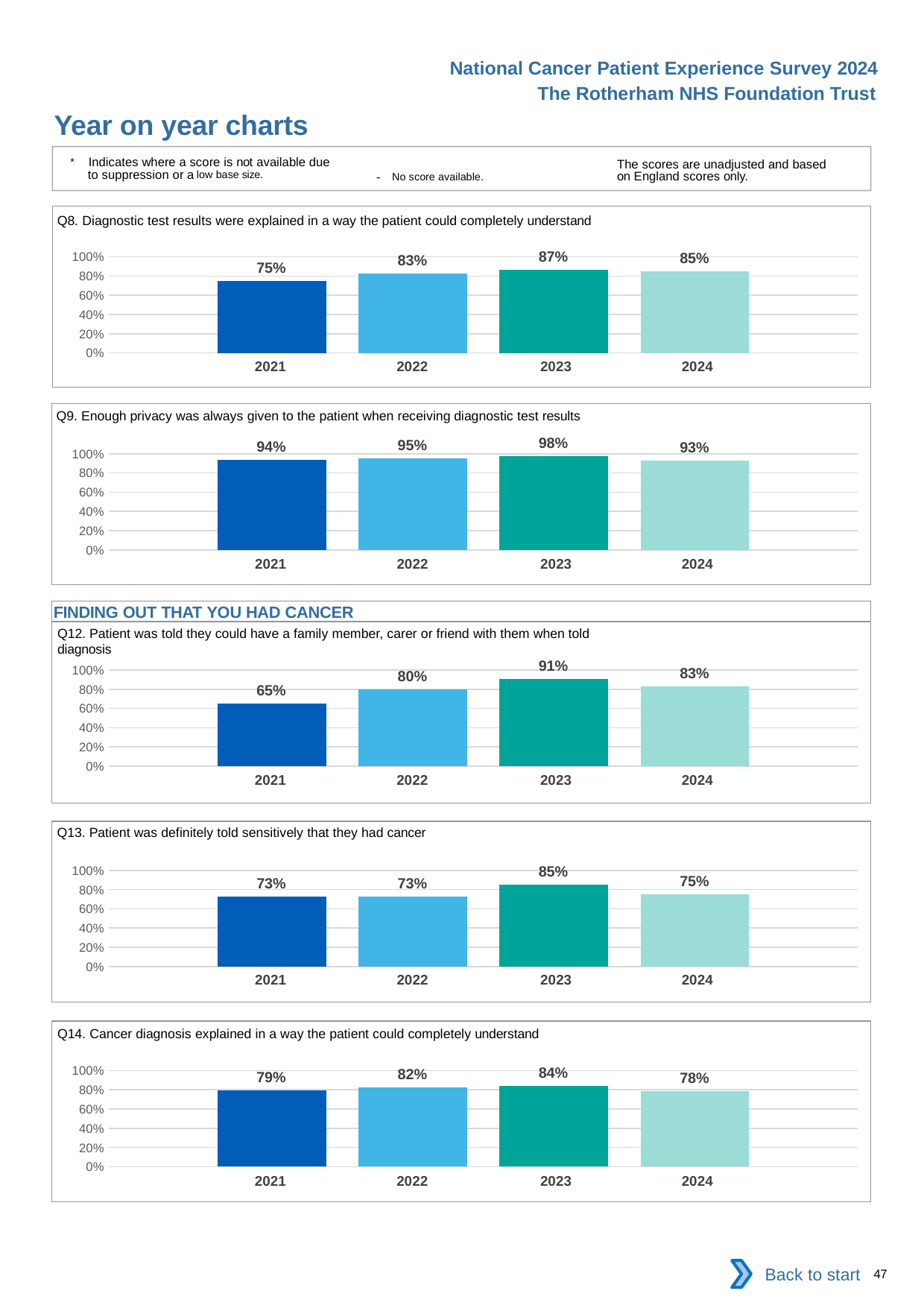
In the Q12 chart, what is the value for 2023? 91% What type of chart is used for Q9? Bar chart In the Q13 chart (Patient was definitely told sensitively that they had cancer), is the value for 2023 larger than the value for 2024? Yes, 2023 (85%) is larger than 2024 (75%) In the Q9 chart (Enough privacy was always given to the patient when receiving diagnostic test results), what is the value for 2024? 93% In the Q14 chart, which year has the lowest value? 2024 In the Q14 chart (Cancer diagnosis explained in a way the patient could completely understand), what is the value for 2024? 78% In the Q8 chart (Diagnostic test results were explained in a way the patient could completely understand), what is the value for 2021? 75% How many years (categories) are shown in the Q8 chart? 4 In the Q8 chart, which year has the highest value? 2023 In the Q12 chart (Patient was told they could have a family member, carer or friend with them when told diagnosis), which year has the lowest value? 2021 In the Q13 chart, what is the difference between the 2023 and 2022 values? 12 percentage points In the Q9 chart, what is the difference between the 2023 and 2021 values? 4 percentage points